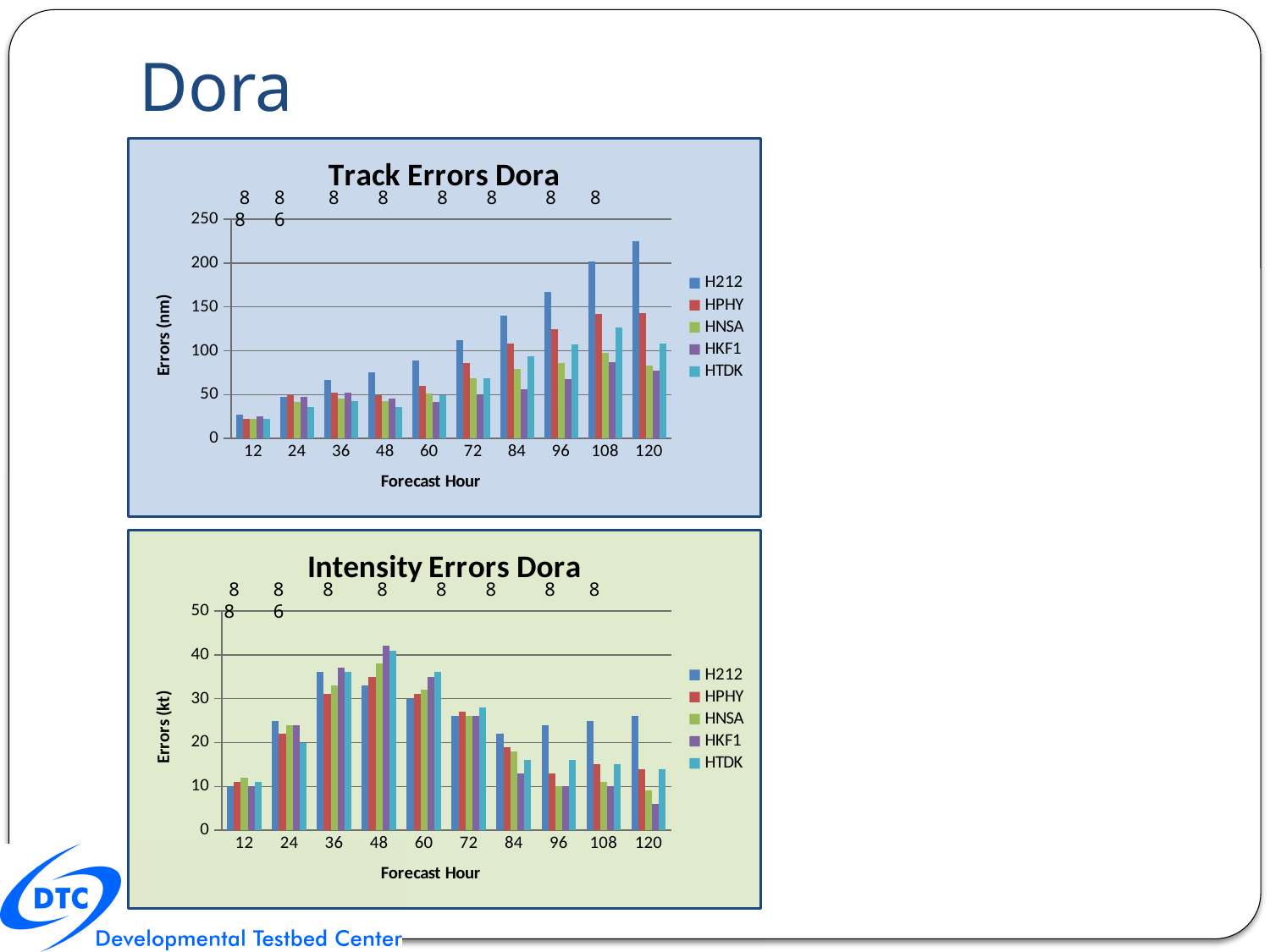
What is the x-axis label of the "Track Errors Dora" chart? Forecast Hour In the "Track Errors Dora" chart, which series has the highest bar at forecast hour 120? H212 What is the y-axis label of the "Intensity Errors Dora" chart? Errors (kt) What type of chart is the "Track Errors Dora" chart? bar chart In the "Track Errors Dora" chart, is the H212 value at forecast hour 120 greater or less than 200? greater In the "Intensity Errors Dora" chart, at forecast hour 96, which is larger: H212 or HPHY? H212 In the "Track Errors Dora" chart, is the HTDK value at forecast hour 12 greater or less than 50? less How many series does the legend of the "Intensity Errors Dora" chart list? 5 In the "Intensity Errors Dora" chart, is the HKF1 value at forecast hour 120 greater or less than 10? less How many forecast hour categories are shown on the x axis of the "Track Errors Dora" chart? 10 In the "Track Errors Dora" chart, do the H212 values generally rise or fall as forecast hour increases? rise In the "Track Errors Dora" chart, at forecast hour 108, which is larger: H212 or HTDK? H212